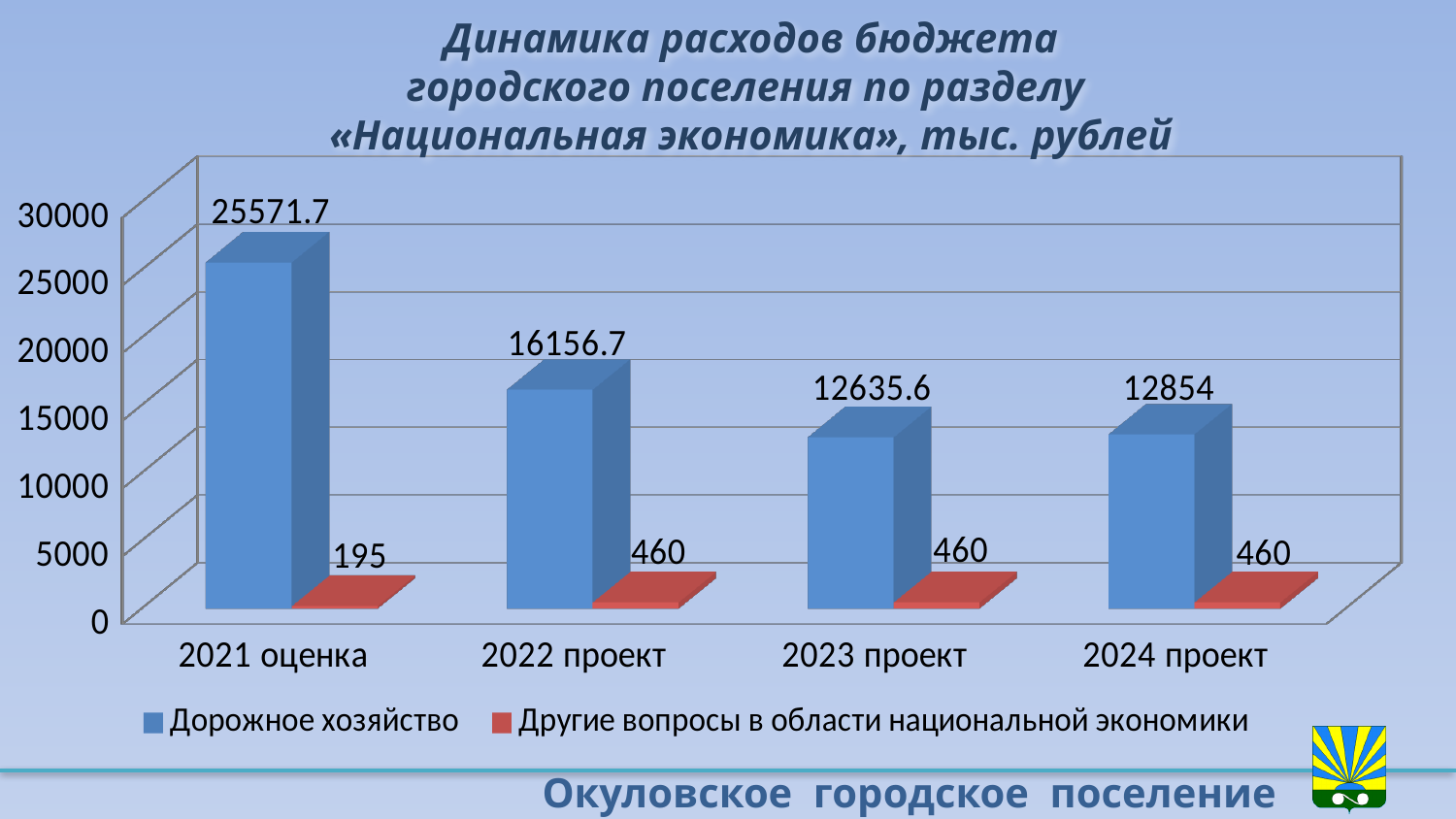
Which year has the lowest value for Дорожное хозяйство? 2023 проект Which is larger: Дорожное хозяйство in 2022 проект or in 2024 проект? 2022 проект What kind of chart is shown on the slide? bar chart Which year has the highest value for Дорожное хозяйство? 2021 оценка What colour are the bars for Другие вопросы в области национальной экономики? red Is the value for Дорожное хозяйство in 2022 проект greater or less than 15000? greater What is the value for Другие вопросы в области национальной экономики in 2021 оценка? 195 What is the difference between the Дорожное хозяйство values for 2021 оценка and 2022 проект? 9415 How many categories are shown on the x axis? 4 How many series does the legend list? 2 What is the value for Дорожное хозяйство in 2021 оценка? 25571.7 What is the value for Дорожное хозяйство in 2023 проект? 12635.6